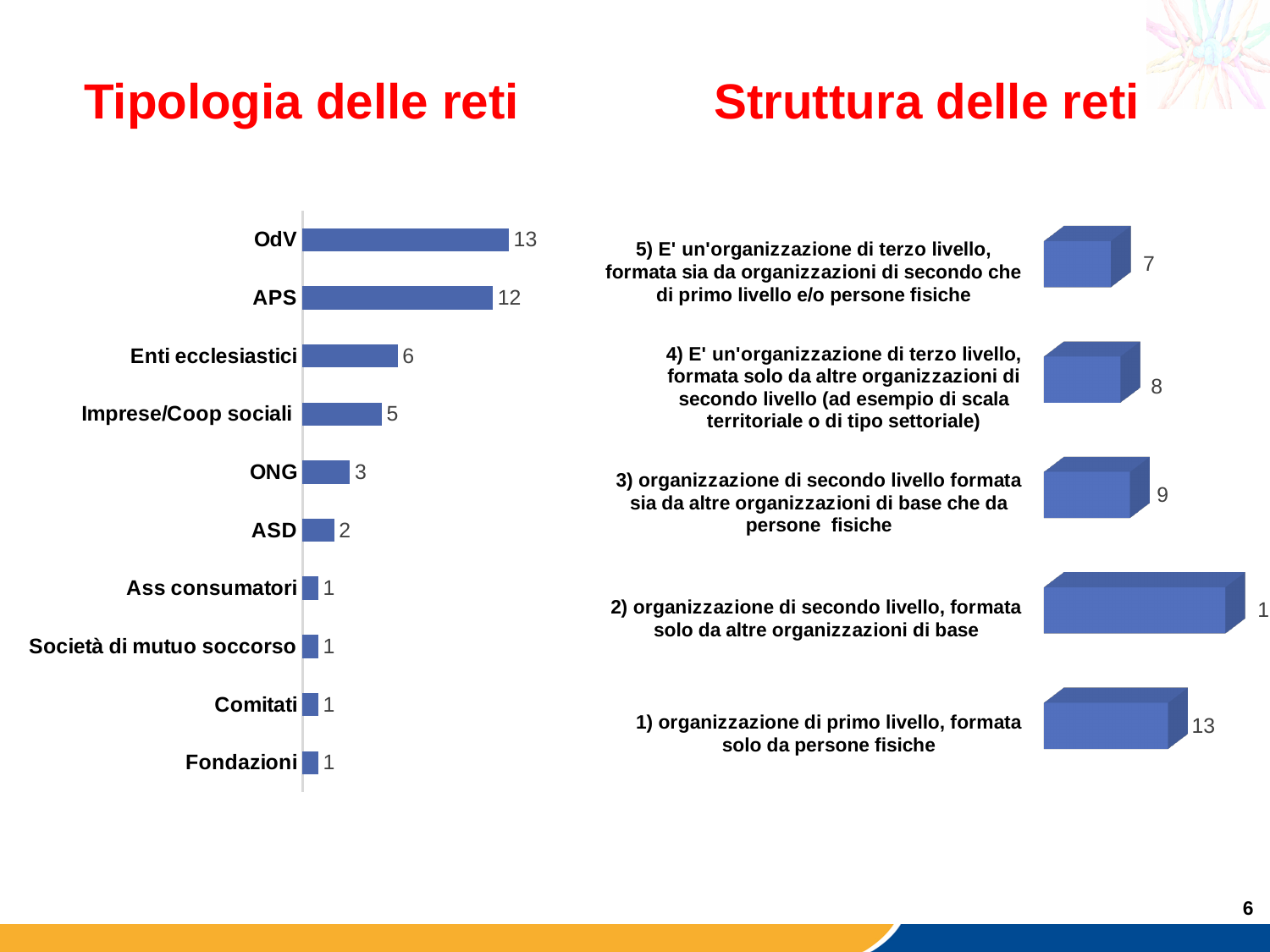
What kind of chart is the 'Tipologia delle reti' chart? Bar chart How many categories are shown in the 'Struttura delle reti' chart? 5 In the 'Struttura delle reti' chart, what is the value for '1) organizzazione di primo livello, formata solo da persone fisiche'? 13 In the 'Tipologia delle reti' chart, which category has the highest value? OdV In the 'Struttura delle reti' chart, which is larger, the value for category 3 or the value for category 5? Category 3 In the 'Tipologia delle reti' chart, which is larger, the value for Imprese/Coop sociali or the value for ONG? Imprese/Coop sociali In the 'Tipologia delle reti' chart, what is the value for OdV? 13 How many categories are shown in the 'Tipologia delle reti' chart? 10 In the 'Tipologia delle reti' chart, what is the value for Enti ecclesiastici? 6 In the 'Struttura delle reti' chart, what is the value for '3) organizzazione di secondo livello formata sia da altre organizzazioni di base che da persone fisiche'? 9 In the 'Tipologia delle reti' chart, what is the difference between the values for OdV and APS? 1 In the 'Struttura delle reti' chart, what is the difference between the values for category 4 and category 5? 1